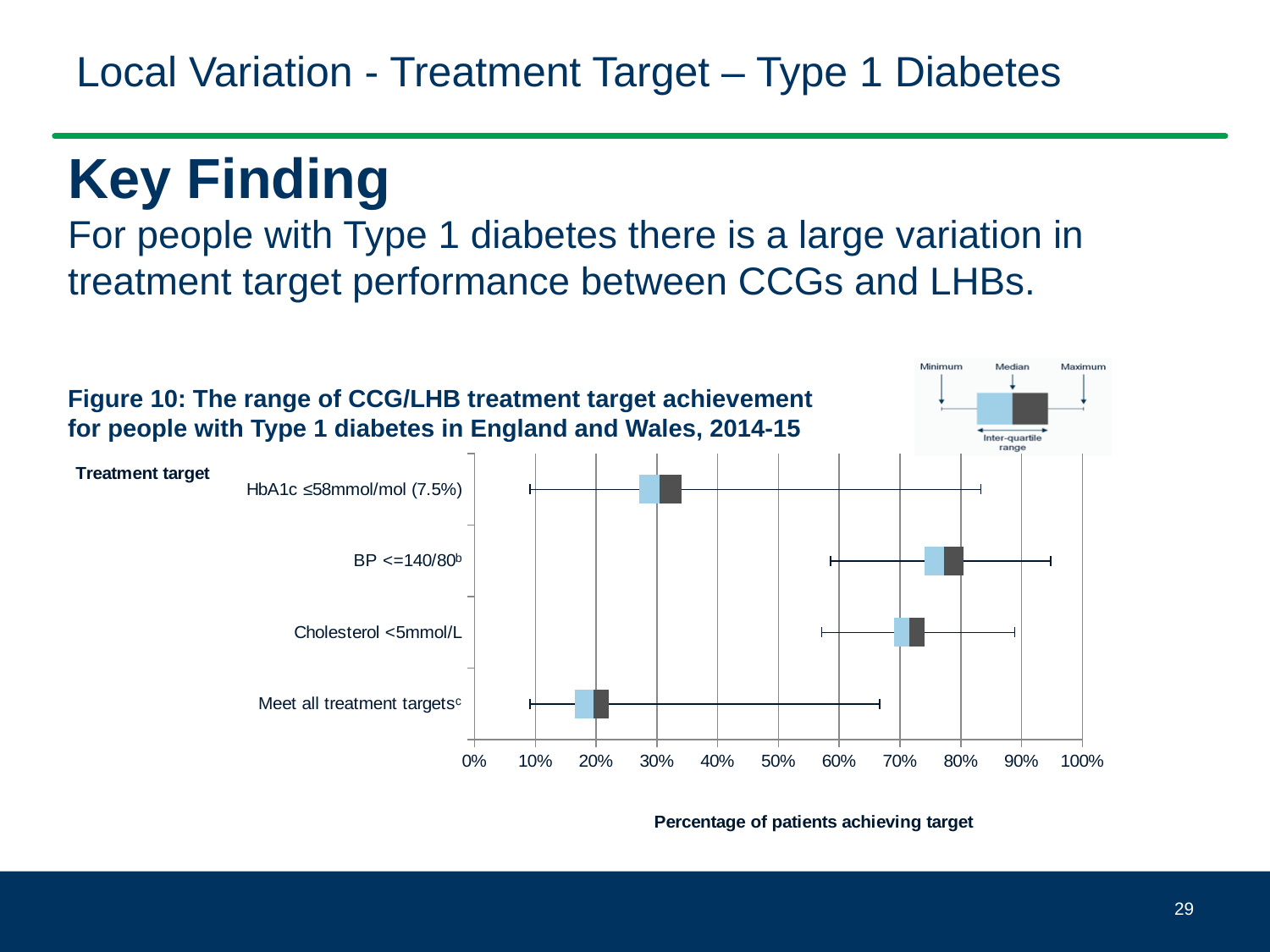
Is the maximum value for HbA1c ≤58mmol/mol (7.5%) greater or less than 90%? less Which has the higher median: HbA1c ≤58mmol/mol (7.5%) or Meet all treatment targets? HbA1c ≤58mmol/mol (7.5%) Is the median for Cholesterol <5mmol/L greater or less than 60%? greater What kind of chart is Figure 10? box plot How many treatment targets are plotted in Figure 10? 4 Is the minimum value for BP <=140/80 greater or less than 50%? greater Which treatment target has the highest median percentage of patients achieving it? BP <=140/80 What is the label of the horizontal axis in Figure 10? Percentage of patients achieving target Which treatment target has the lowest median percentage of patients achieving it? Meet all treatment targets